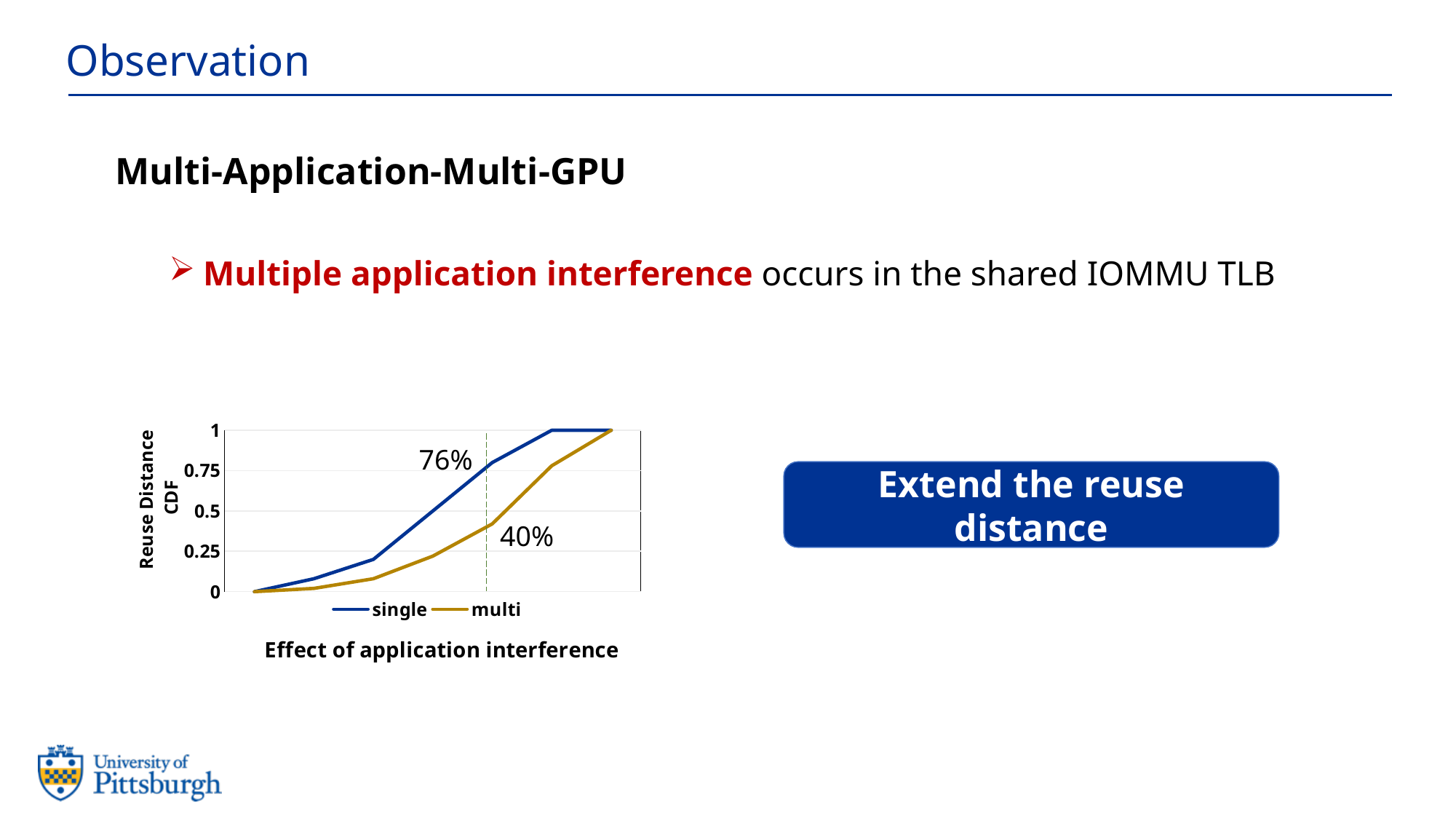
At the dashed vertical line, is the value for the 'single' series greater or less than 0.75? greater What percentage is annotated on the 'single' line at the dashed vertical line? 76% What colour is the line for the 'multi' series? gold How many series does the legend list? 2 At the dashed vertical line, is the value for the 'multi' series greater or less than 0.5? less What are the names of the two series in the legend? single and multi What percentage is annotated on the 'multi' line at the dashed vertical line? 40% Do the CDF values rise or fall along the x axis? rise At the dashed vertical line, which series has the higher CDF value, single or multi? single What kind of chart is shown on the slide? line chart What is the difference between the annotated values 76% and 40% at the dashed vertical line? 36% What is the highest tick value shown on the y axis? 1